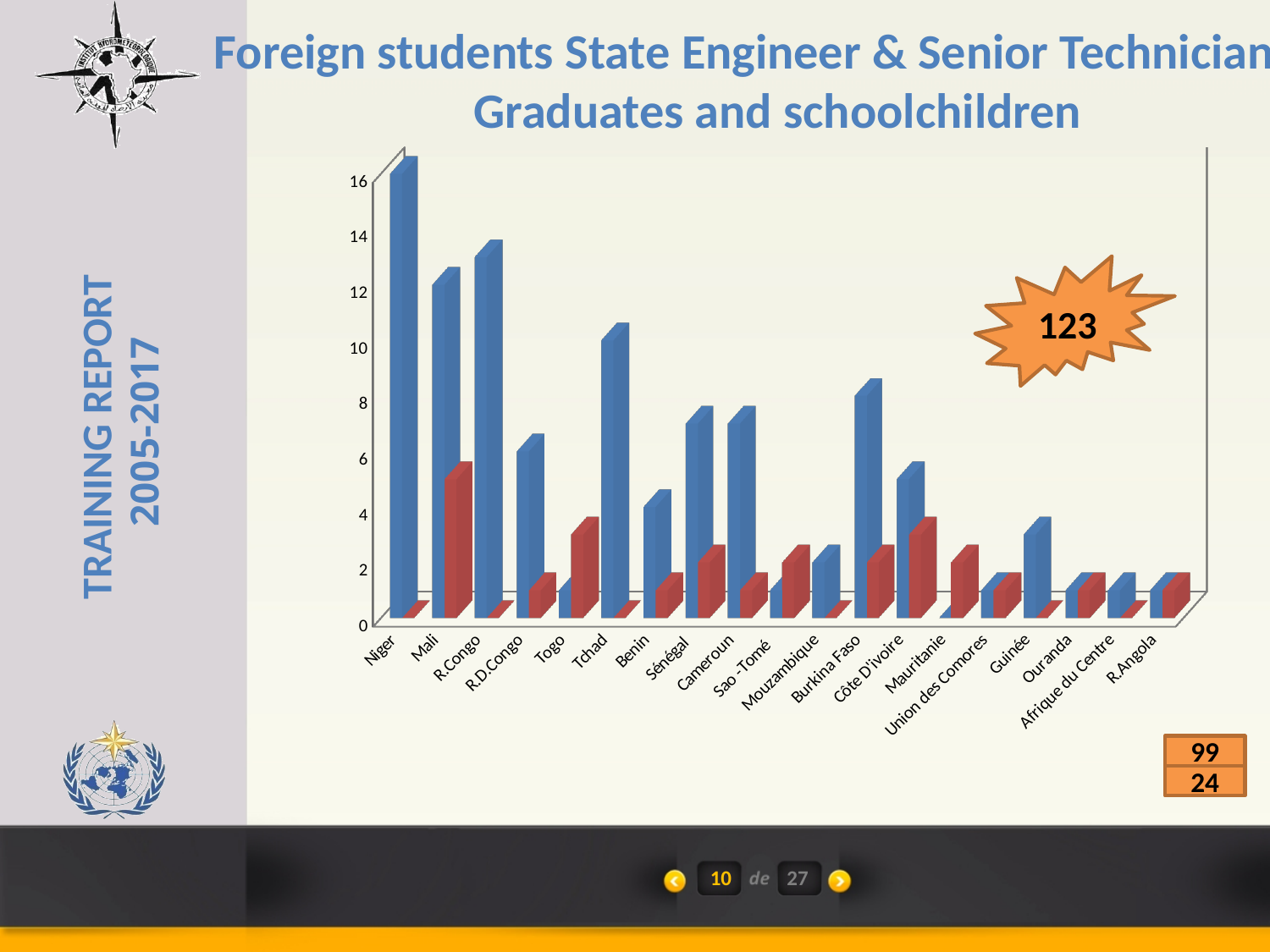
Which has the taller blue bar, Niger or Mali? Niger Is the blue bar for Tchad greater or less than 8? greater What kind of chart is shown on the slide? bar chart Which has the taller red bar, Mali or Togo? Mali Is the blue bar for Togo greater or less than 2? less Which country has the tallest blue bar? Niger What number is shown in the orange starburst next to the chart? 123 Which has the taller blue bar, Tchad or Benin? Tchad Is the blue bar for Niger greater or less than 14? greater How many countries are listed along the x axis of the chart? 19